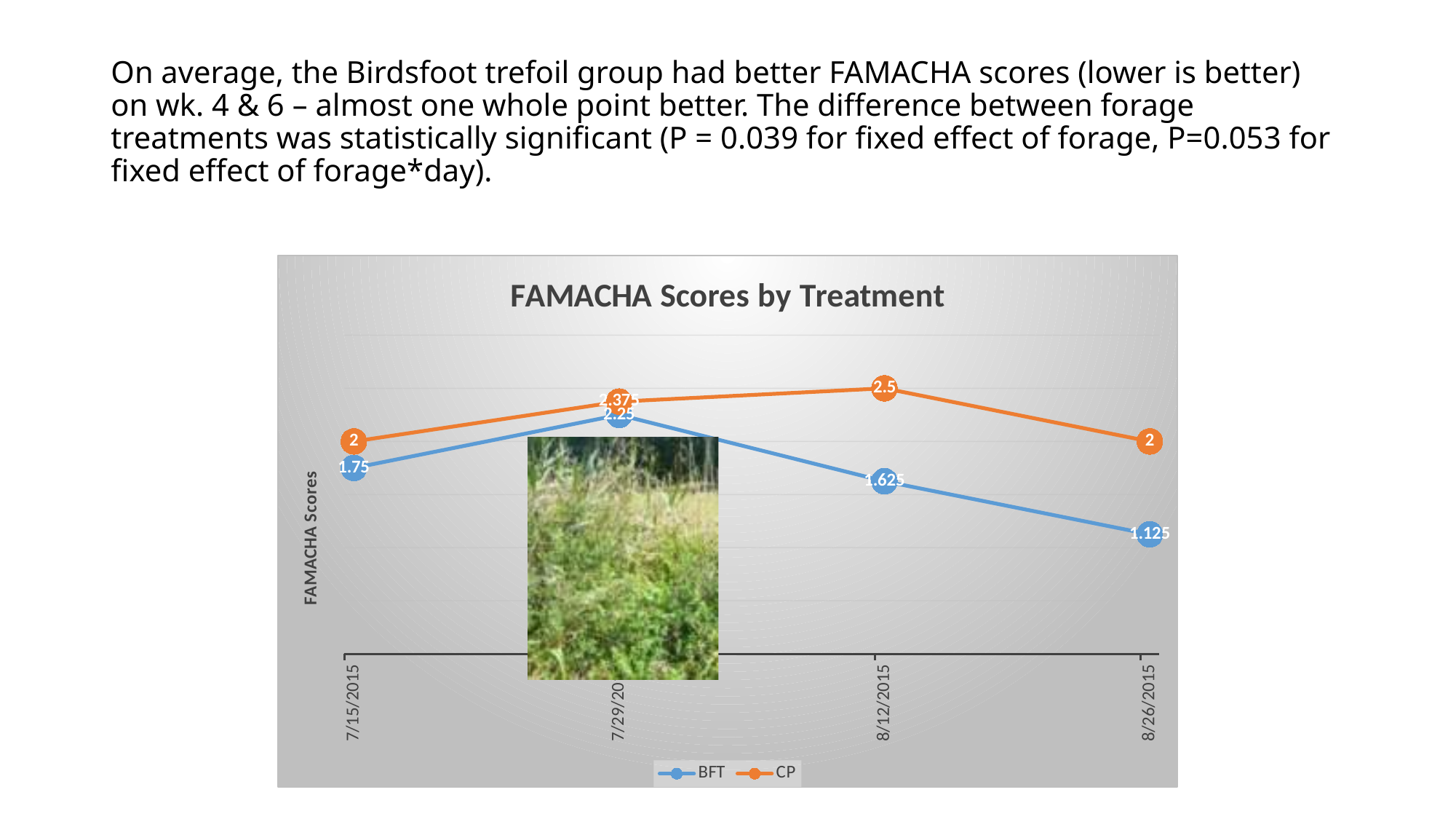
What is the BFT FAMACHA score on 8/26/2015? 1.125 What kind of chart is shown on the slide? line chart How many series does the legend of the FAMACHA Scores by Treatment chart list? 2 What is the CP FAMACHA score on 8/12/2015? 2.5 On which date does the CP series reach its highest FAMACHA score? 8/12/2015 What is the BFT FAMACHA score on 7/15/2015? 1.75 On which date does the BFT series have its lowest FAMACHA score? 8/26/2015 On 7/15/2015, which series has the higher FAMACHA score, BFT or CP? CP What is the CP FAMACHA score on 8/26/2015? 2 What is the difference between the CP and BFT scores on 8/26/2015? 0.875 How many dates are plotted along the x axis of the chart? 4 What is the title of the chart? FAMACHA Scores by Treatment